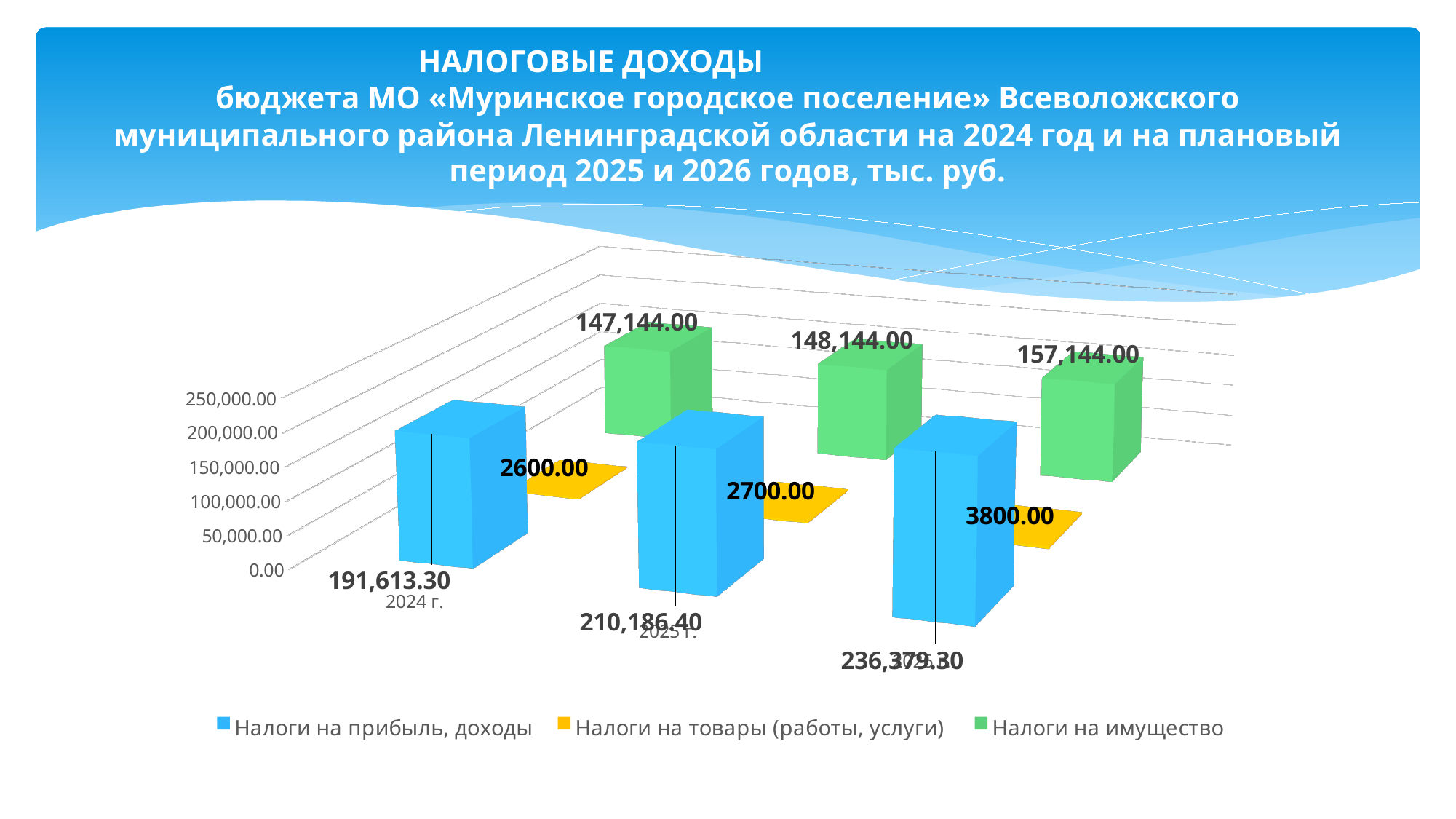
How many series does the legend list? 3 What is the value for Налоги на товары (работы, услуги) in 2026 г.? 3800.00 What is the difference between Налоги на прибыль, доходы in 2025 г. and in 2024 г.? 18,573.10 Do the values for Налоги на прибыль, доходы rise or fall from 2024 г. to 2026 г.? Rise In which year is Налоги на имущество lowest? 2024 г. What is the value for Налоги на прибыль, доходы in 2024 г.? 191,613.30 What is the value for Налоги на прибыль, доходы in 2025 г.? 210,186.40 What kind of chart is shown on the slide? Bar chart In which year is Налоги на прибыль, доходы highest? 2026 г. What is the difference between Налоги на имущество in 2026 г. and in 2024 г.? 10,000.00 What is the value for Налоги на имущество in 2025 г.? 148,144.00 Which is larger in 2024 г.: Налоги на прибыль, доходы or Налоги на имущество? Налоги на прибыль, доходы